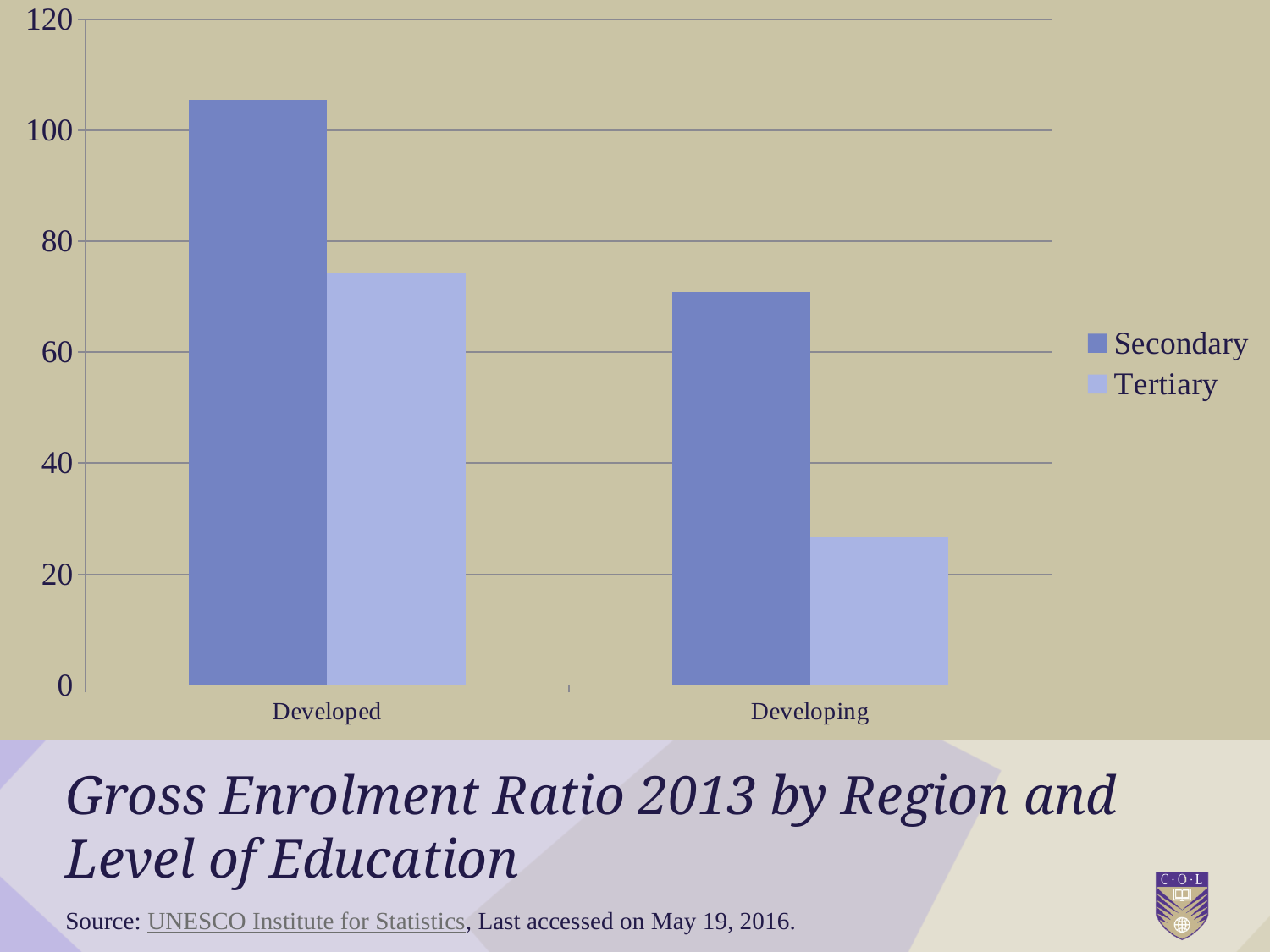
Which is larger for Developing: the Secondary value or the Tertiary value? Secondary Is the Secondary value for Developed greater or less than 100? greater Which is larger: the Tertiary value for Developed or the Secondary value for Developing? Tertiary value for Developed Is the Tertiary value for Developed greater or less than 80? less Is the Tertiary value for Developing greater or less than 40? less Which region has the lowest Tertiary value? Developing How many series does the legend list? 2 What is the title of the chart? Gross Enrolment Ratio 2013 by Region and Level of Education What kind of chart is shown on the slide? bar chart How many region categories are shown on the x axis? 2 Which region has the highest Secondary value? Developed